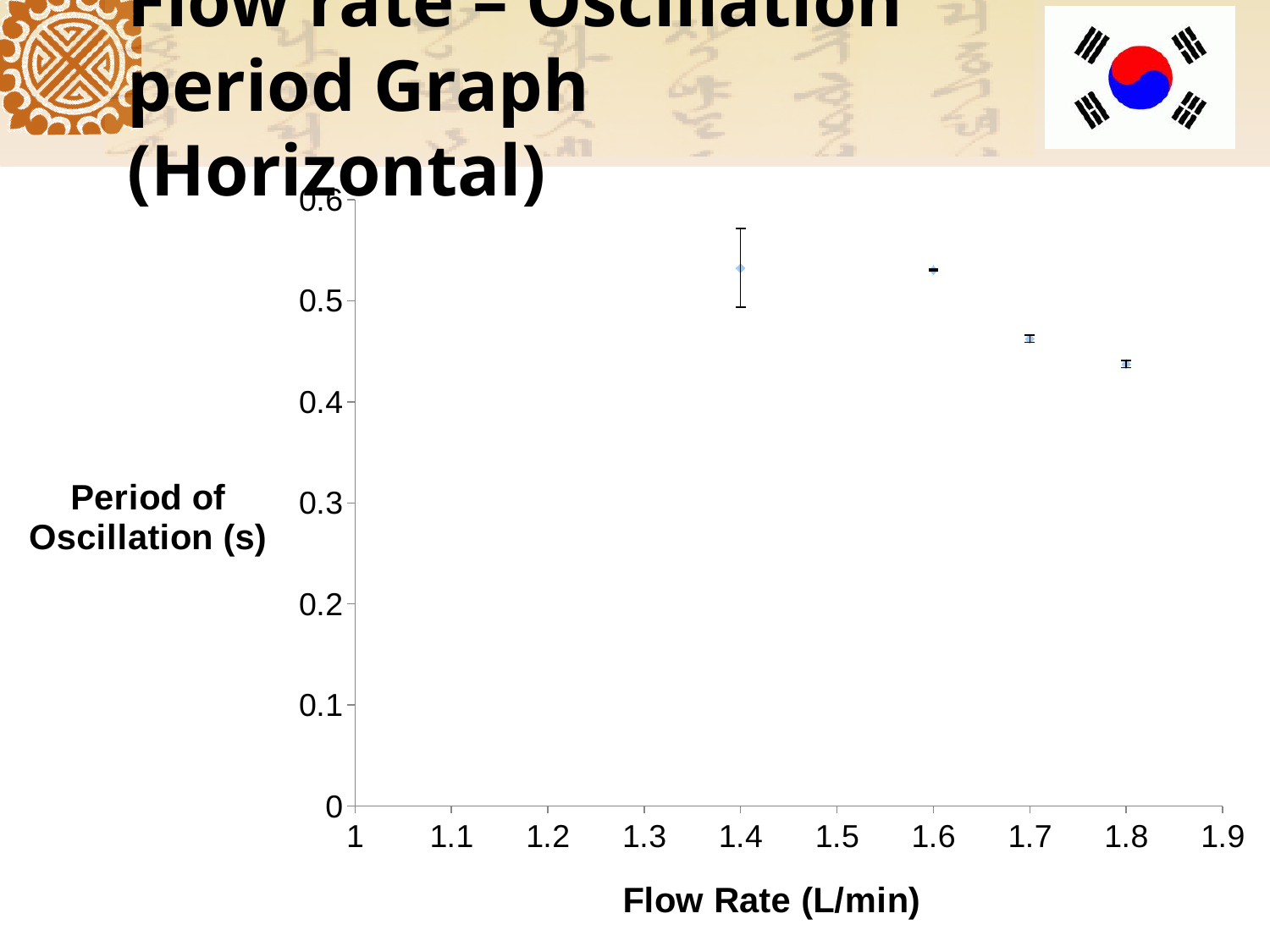
Is the period of oscillation at a flow rate of 1.4 L/min greater or less than 0.5? greater Is the period of oscillation at a flow rate of 1.7 L/min greater or less than 0.4? greater Is the period of oscillation at a flow rate of 1.8 L/min greater or less than 0.5? less What is the label of the y axis? Period of Oscillation (s) How many data points are plotted on the chart? 4 Does the period of oscillation rise or fall as the flow rate increases along the x axis? fall Which flow rate has the lowest period of oscillation? 1.8 What is the label of the x axis? Flow Rate (L/min) What kind of chart is shown on the slide? scatter chart Which has the larger period of oscillation: the point at 1.7 L/min or the point at 1.8 L/min? 1.7 L/min